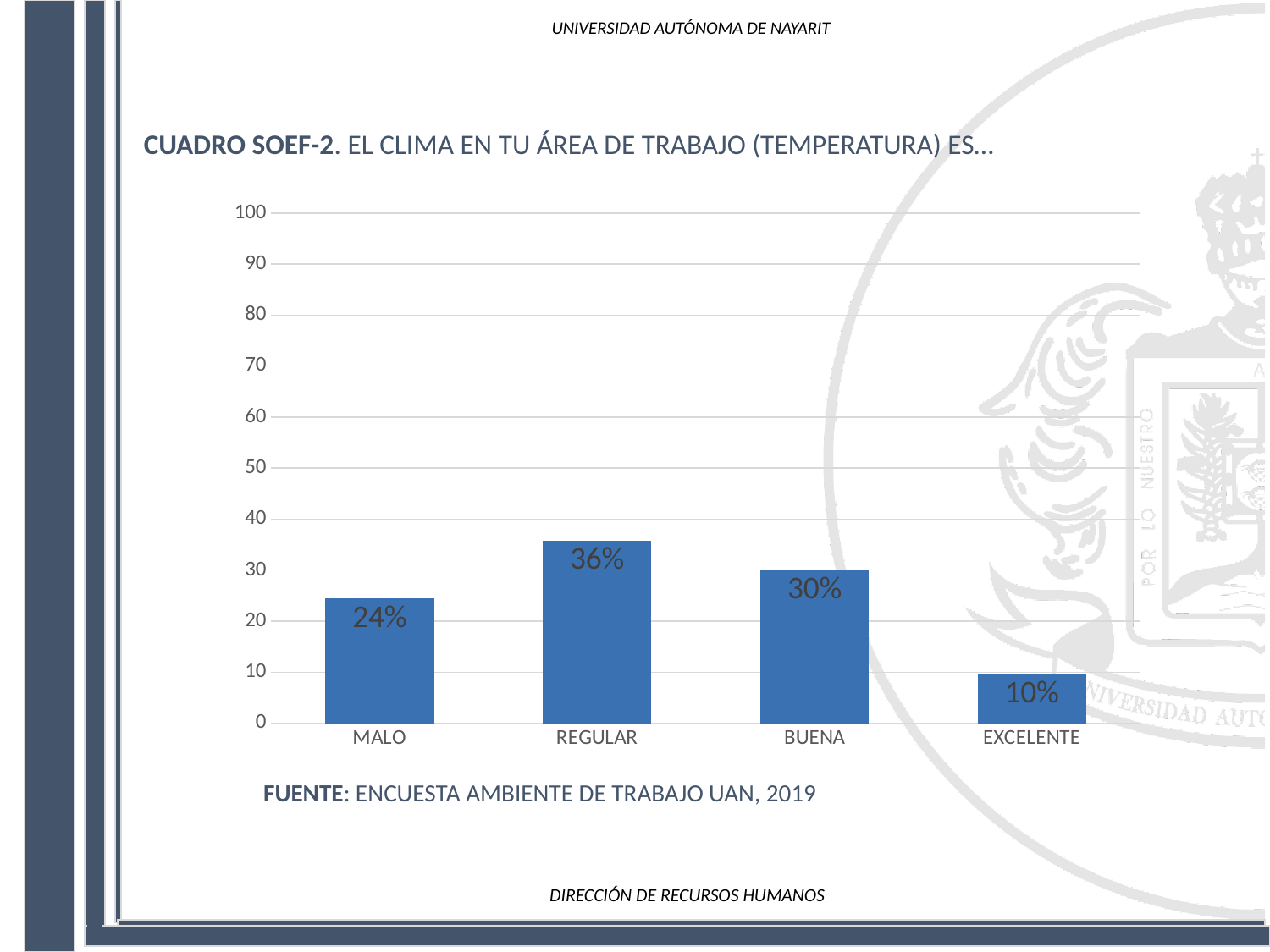
Is the value for BUENA greater or less than 20? greater How many categories are shown on the x axis? 4 What source is cited below the chart? ENCUESTA AMBIENTE DE TRABAJO UAN, 2019 What is the value for MALO? 24% What is the difference between the values for REGULAR and BUENA? 6% What is the value for EXCELENTE? 10% Which is larger, the value for MALO or the value for BUENA? BUENA Which category has the lowest value? EXCELENTE What is the difference between the values for MALO and EXCELENTE? 14% What kind of chart is shown on the slide? bar chart Which category has the highest value? REGULAR What is the value for REGULAR? 36%